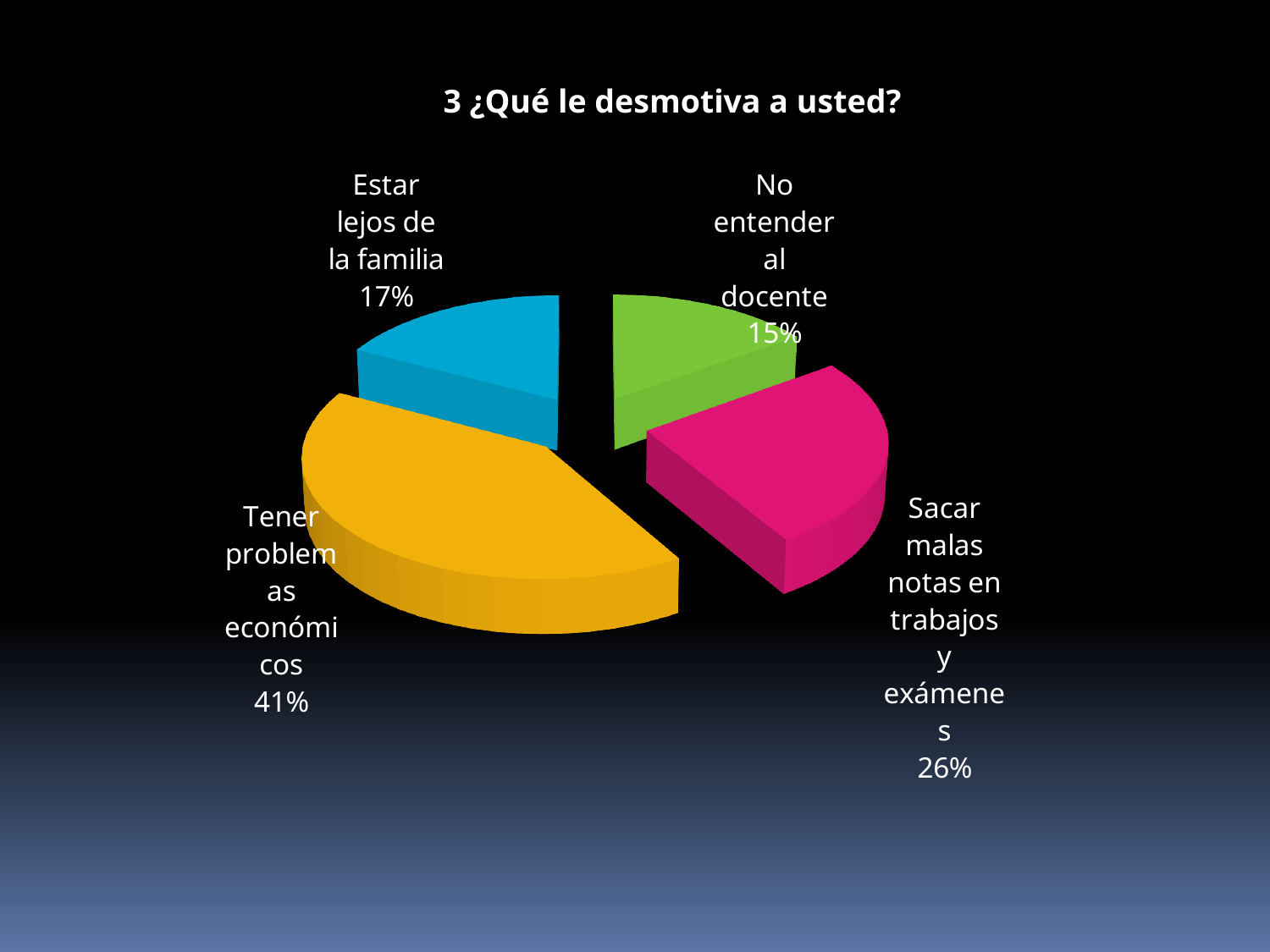
What is the title of the chart? 3 ¿Qué le desmotiva a usted? What percentage is shown for 'Estar lejos de la familia'? 17% What type of chart is shown on the slide? Pie chart Which category has the largest share of the pie? Tener problemas económicos What percentage is shown for 'Tener problemas económicos'? 41% Which category has the smallest share of the pie? No entender al docente What percentage is shown for 'No entender al docente'? 15% What is the difference in percentage points between 'Tener problemas económicos' and 'Sacar malas notas en trabajos y exámenes'? 15 percentage points How many slices does the pie chart have? 4 What percentage is shown for 'Sacar malas notas en trabajos y exámenes'? 26% Which is larger: the share for 'Estar lejos de la familia' or the share for 'No entender al docente'? Estar lejos de la familia What colour is the slice for 'Tener problemas económicos'? Yellow/orange